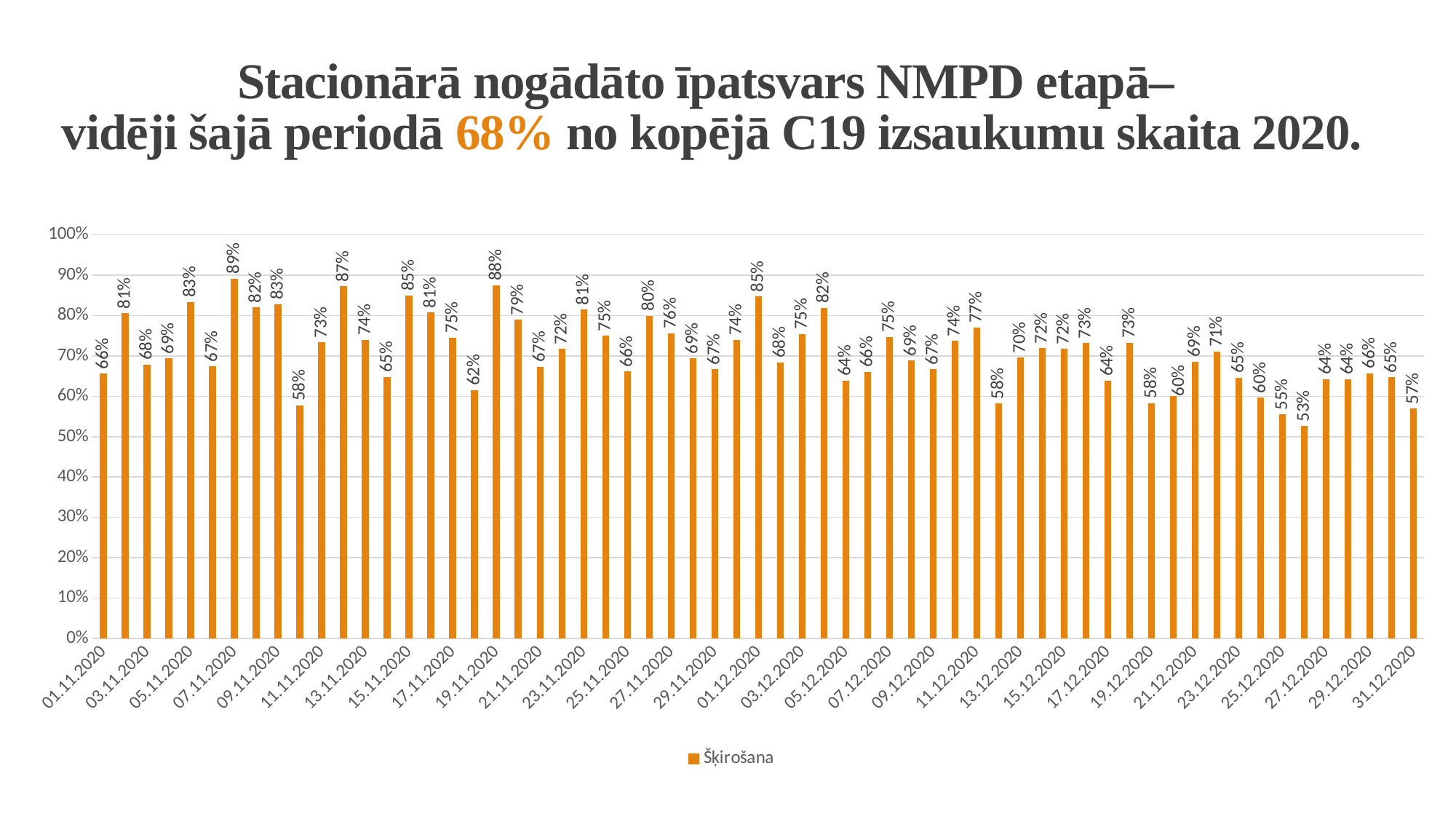
What is the value for 01.12.2020? 85% What is the value for 07.11.2020? 89% What is the lowest value shown in the chart? 53% What is the name of the series in the legend? Šķirošana What is the difference between the values for 07.11.2020 and 31.12.2020? 32 percentage points Which has the larger value, 19.11.2020 or 25.12.2020? 19.11.2020 On which date is the value highest? 07.11.2020 How many series does the legend list? 1 What is the value for 31.12.2020? 57% Overall, do the values rise or fall from 01.11.2020 to 31.12.2020? Fall What is the value for 25.12.2020? 55% What kind of chart is shown on the slide? Bar chart